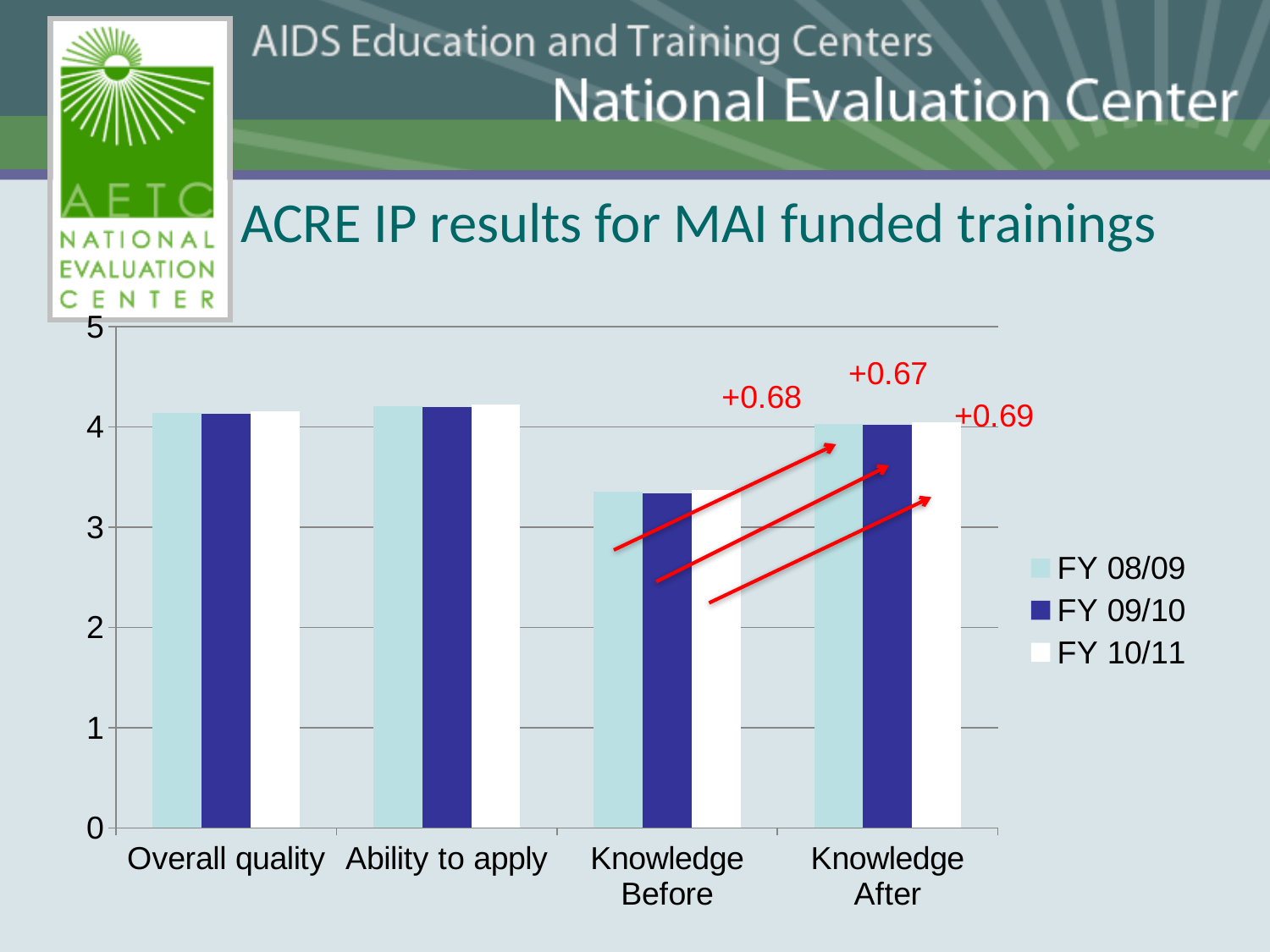
How many categories are shown on the x axis? 4 Is the FY 08/09 value for Overall quality greater or less than 4? greater What increase from Knowledge Before to Knowledge After is annotated for FY 08/09? +0.68 Is the FY 10/11 value for Ability to apply greater or less than 4? greater Which category has the lowest values across all three fiscal years? Knowledge Before How many series does the legend list? 3 For FY 09/10, which is larger: Knowledge Before or Knowledge After? Knowledge After Is the FY 08/09 value for Knowledge Before greater or less than 4? less What kind of chart is shown on the slide? bar chart What is the title of the chart on the slide? ACRE IP results for MAI funded trainings Which series is shown in dark blue in the legend? FY 09/10